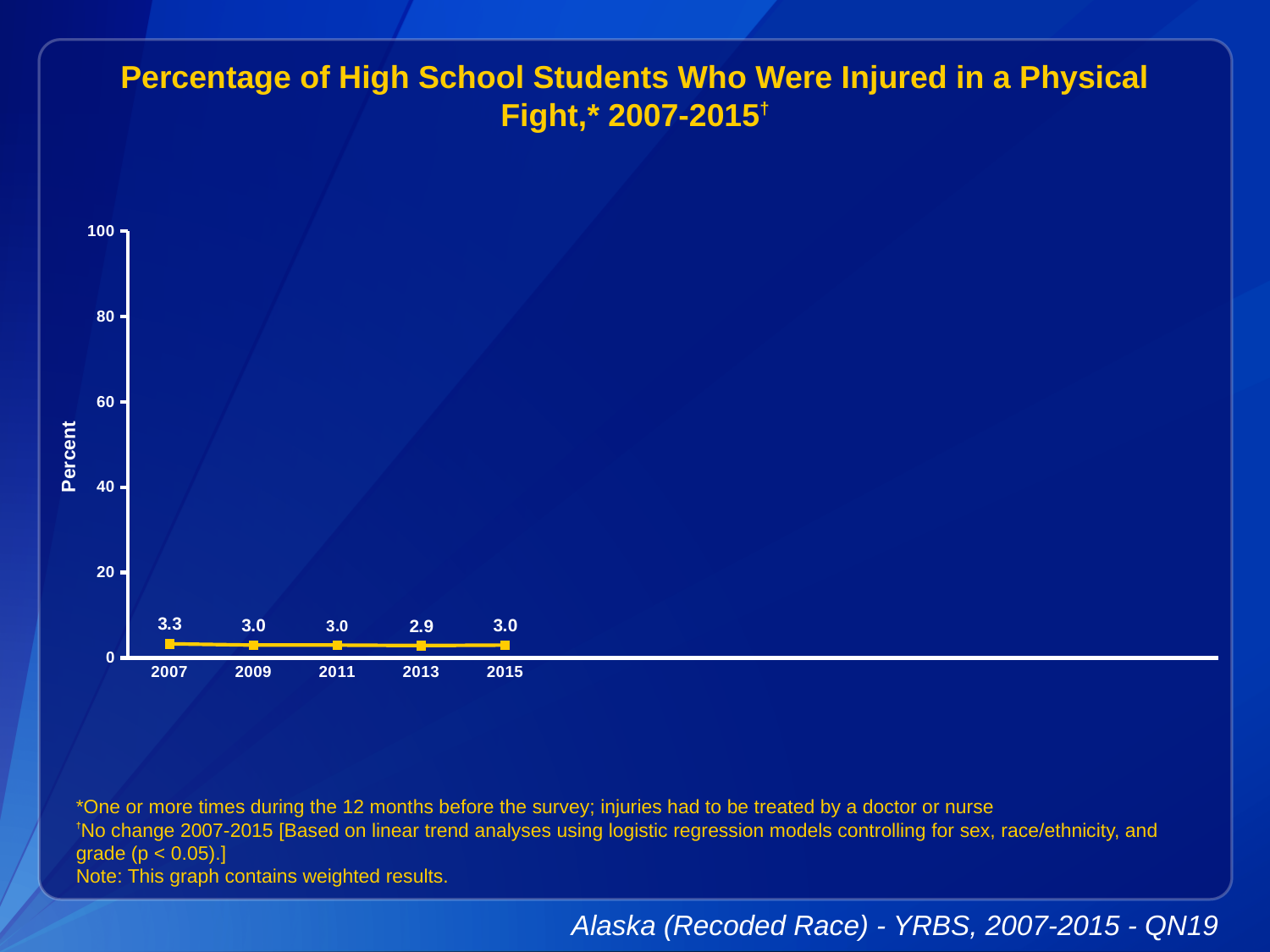
What is the label on the y axis? Percent What kind of chart is shown? line chart Which is larger, the value for 2007 or the value for 2009? 2007 How many years are plotted on the chart? 5 Which year has the lowest value? 2013 Which year has the highest value? 2007 What is the value for 2015? 3.0 What is the value for 2007? 3.3 Is the value for 2011 greater or less than 20? less What is the difference between the values for 2007 and 2013? 0.4 What is the value for 2013? 2.9 What is the maximum value shown on the y axis? 100